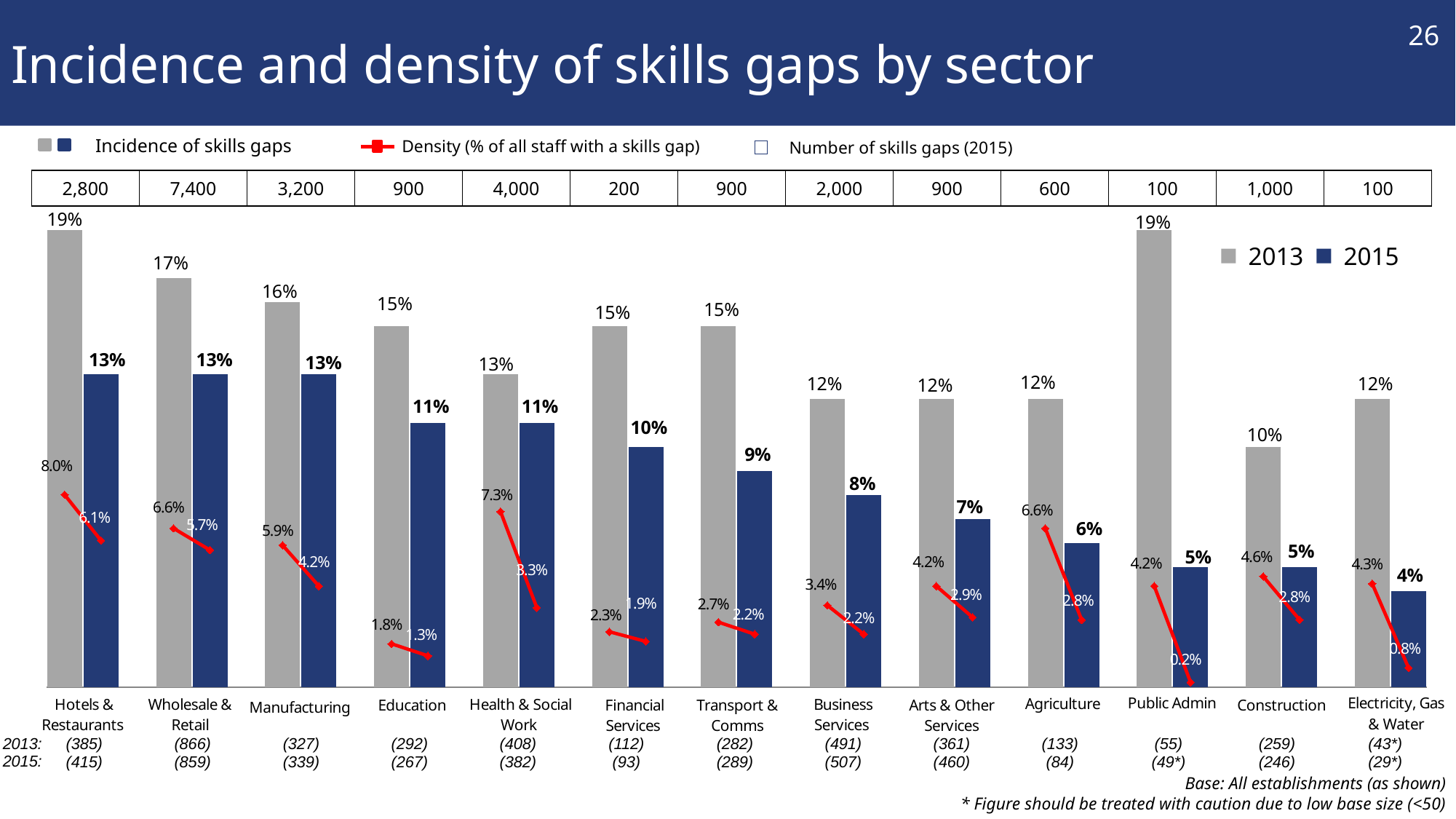
What is the number of skills gaps (2015) shown for Wholesale & Retail? 7,400 What was the density of skills gaps in Health & Social Work in 2013? 7.3% Which sector had the lowest incidence of skills gaps in 2015? Electricity, Gas & Water Which sector had the lowest incidence of skills gaps in 2013? Construction Which was higher in 2015: the incidence of skills gaps in Financial Services or in Transport & Comms? Financial Services Which sector has the highest number of skills gaps (2015)? Wholesale & Retail What type of chart is used to show the incidence of skills gaps? Bar chart How many years does the 2013/2015 legend list for the incidence bars? 2 What was the incidence of skills gaps in Hotels & Restaurants in 2015? 13% How many sectors are shown on the chart? 13 What was the density of skills gaps in Public Admin in 2015? 0.2% By how many percentage points did the incidence of skills gaps in Public Admin fall from 2013 to 2015? 14 percentage points